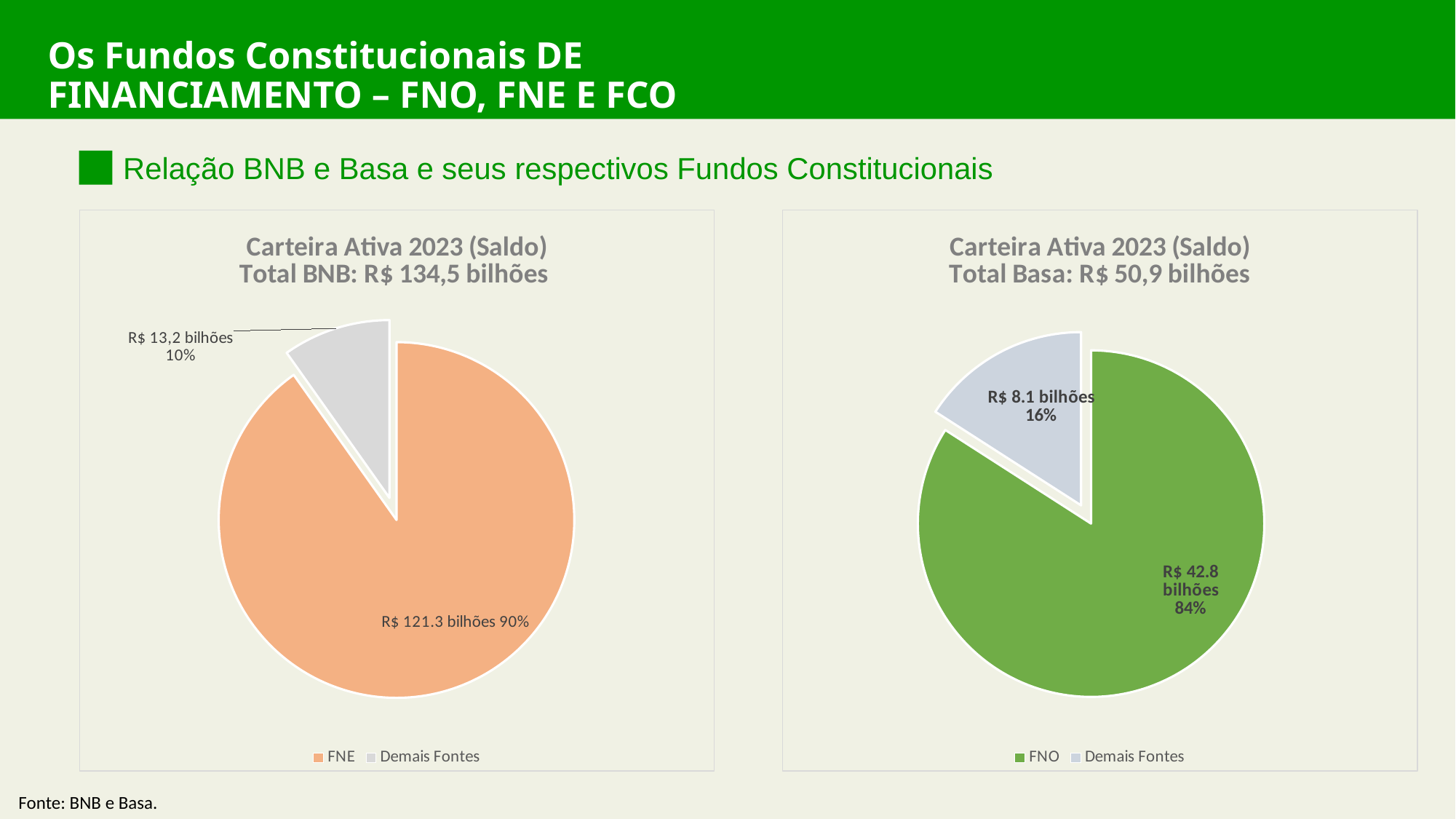
In the right chart (Total Basa), which is larger, FNO or Demais Fontes? FNO In the right chart (Total Basa), what is the value for Demais Fontes? R$ 8.1 bilhões How many slices does the left chart (Total BNB) have? 2 In the left chart (Total BNB), what share of the pie does FNE represent? 90% What total is stated in the title of the right chart? R$ 50,9 bilhões In the left chart (Total BNB), what is the value for Demais Fontes? R$ 13,2 bilhões In the right chart (Total Basa), which slice is the smallest? Demais Fontes In the left chart (Total BNB), which slice is the largest? FNE What kind of chart is the left chart (Total BNB)? pie chart In the right chart (Total Basa), what share of the pie does Demais Fontes represent? 16% In the right chart (Total Basa), what is the value for FNO? R$ 42.8 bilhões In the left chart (Total BNB), what is the value for FNE? R$ 121.3 bilhões